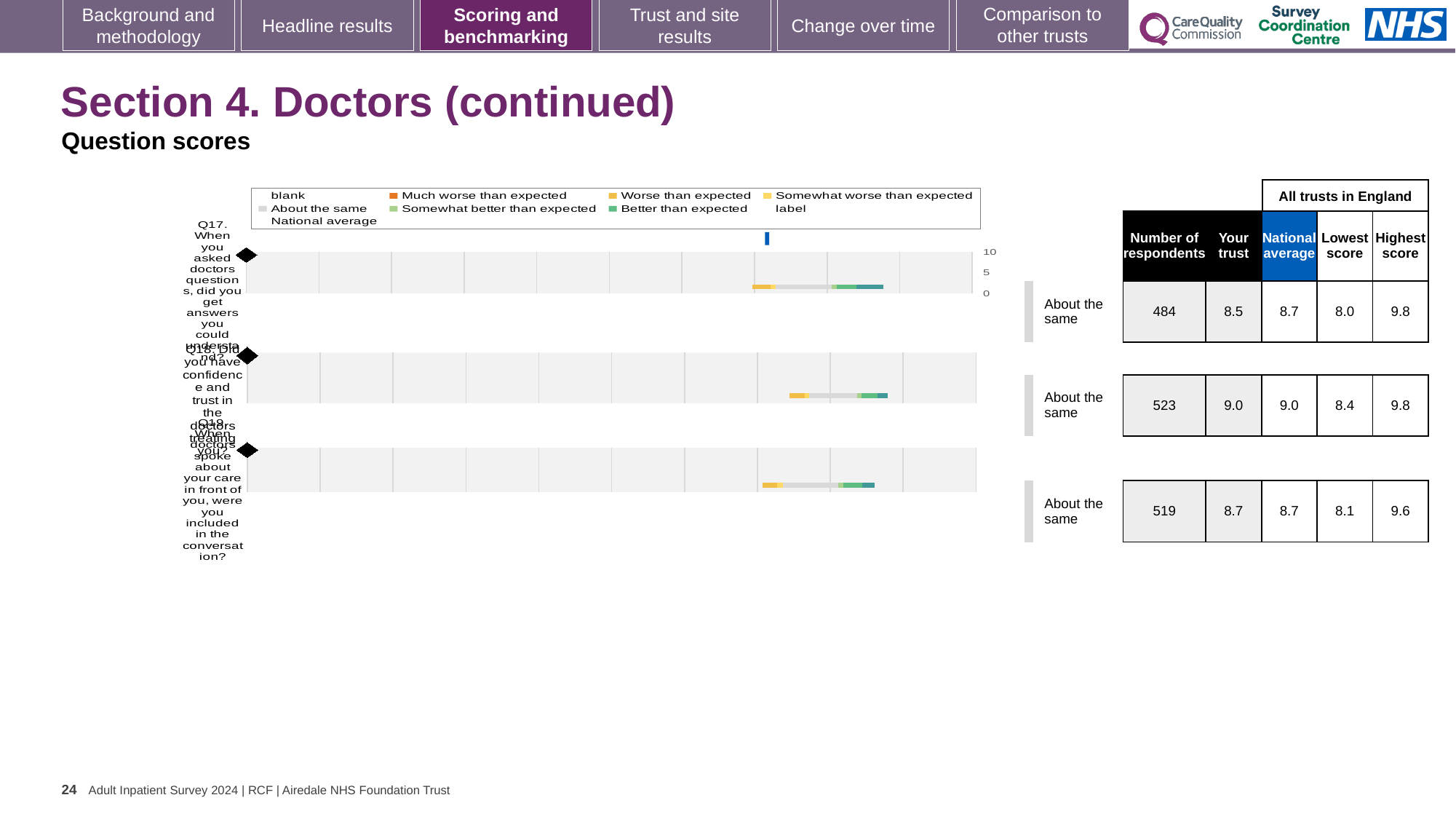
For Q17, which is larger: the 'Your trust' score or the national average? National average What benchmark category is shown next to Q19's bar? About the same What is the 'Your trust' score for Q17 (When you asked doctors questions, did you get answers you could understand)? 8.5 What is the national average score for Q19 (When doctors spoke about your care in front of you, were you included in the conversation)? 8.7 What kind of chart is shown on the slide? bar chart For Q18, what is the difference between the highest score and the lowest score across all trusts in England? 1.4 What is the 'Your trust' score for Q18 (Did you have confidence and trust in the doctors treating you)? 9.0 Is the 'Your trust' value for Q17 greater or less than 5 on the chart axis? greater How many questions (categories) are plotted in the chart? 3 Which question has the lowest 'Your trust' score? Q17 Which question has the highest 'Your trust' score? Q18 How many respondents answered Q18? 523